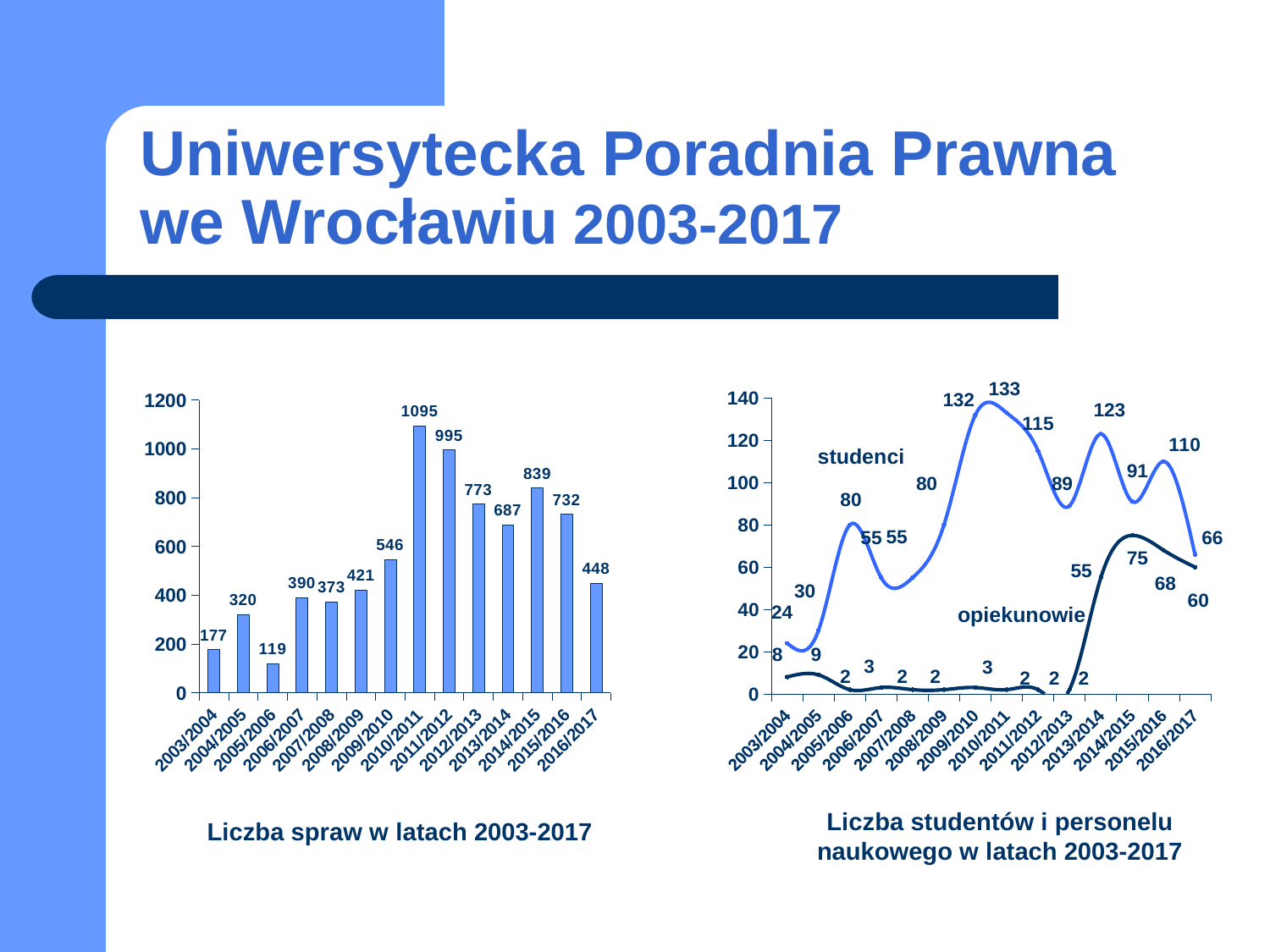
In the chart "Liczba studentów i personelu naukowego w latach 2003-2017", what is the difference between the studenci values for 2009/2010 and 2008/2009? 52 How many bars are shown in the chart "Liczba spraw w latach 2003-2017"? 14 How many series are plotted in the chart "Liczba studentów i personelu naukowego w latach 2003-2017"? 2 In the chart "Liczba studentów i personelu naukowego w latach 2003-2017", what is the highest value of the studenci series? 133 In the chart "Liczba spraw w latach 2003-2017", what is the value for 2016/2017? 448 In the chart "Liczba spraw w latach 2003-2017", which year has the lowest value? 2005/2006 What kind of chart is the chart titled "Liczba spraw w latach 2003-2017"? bar chart In the chart "Liczba spraw w latach 2003-2017", which is larger, the value for 2014/2015 or 2015/2016? 2014/2015 In the chart "Liczba studentów i personelu naukowego w latach 2003-2017", what is the value of opiekunowie for 2014/2015? 75 In the chart "Liczba spraw w latach 2003-2017", what is the difference between the values for 2010/2011 and 2011/2012? 100 What kind of chart is the chart titled "Liczba studentów i personelu naukowego w latach 2003-2017"? line chart In the chart "Liczba spraw w latach 2003-2017", what is the value for 2010/2011? 1095